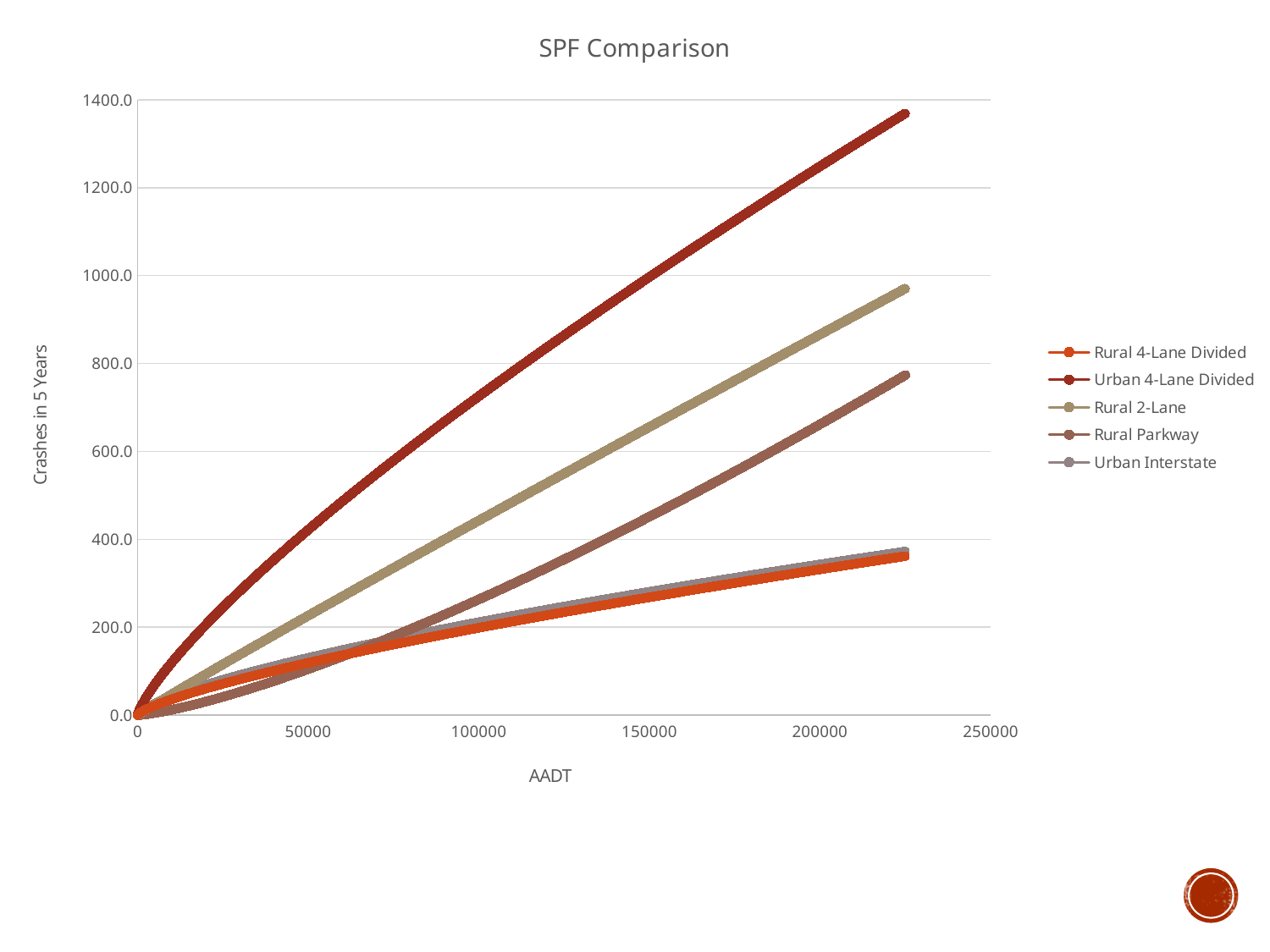
Is the value for Urban 4-Lane Divided at its right-hand end greater or less than 1200? greater What is the title of the chart? SPF Comparison How many series does the legend list? 5 What kind of chart is shown on the slide? line chart Do the values for Urban 4-Lane Divided rise or fall as AADT increases? rise Is the value for Rural 2-Lane at its right-hand end greater or less than 1000? less At an AADT of 200000, which is larger: Urban 4-Lane Divided or Rural 2-Lane? Urban 4-Lane Divided Which series has the lowest value at an AADT of 50000? Rural Parkway Is the value for Urban Interstate at its right-hand end greater or less than 400? less What is the label of the vertical axis? Crashes in 5 Years Which series reaches the highest number of crashes at the right end of the chart? Urban 4-Lane Divided At an AADT of 200000, which is larger: Rural Parkway or Urban Interstate? Rural Parkway